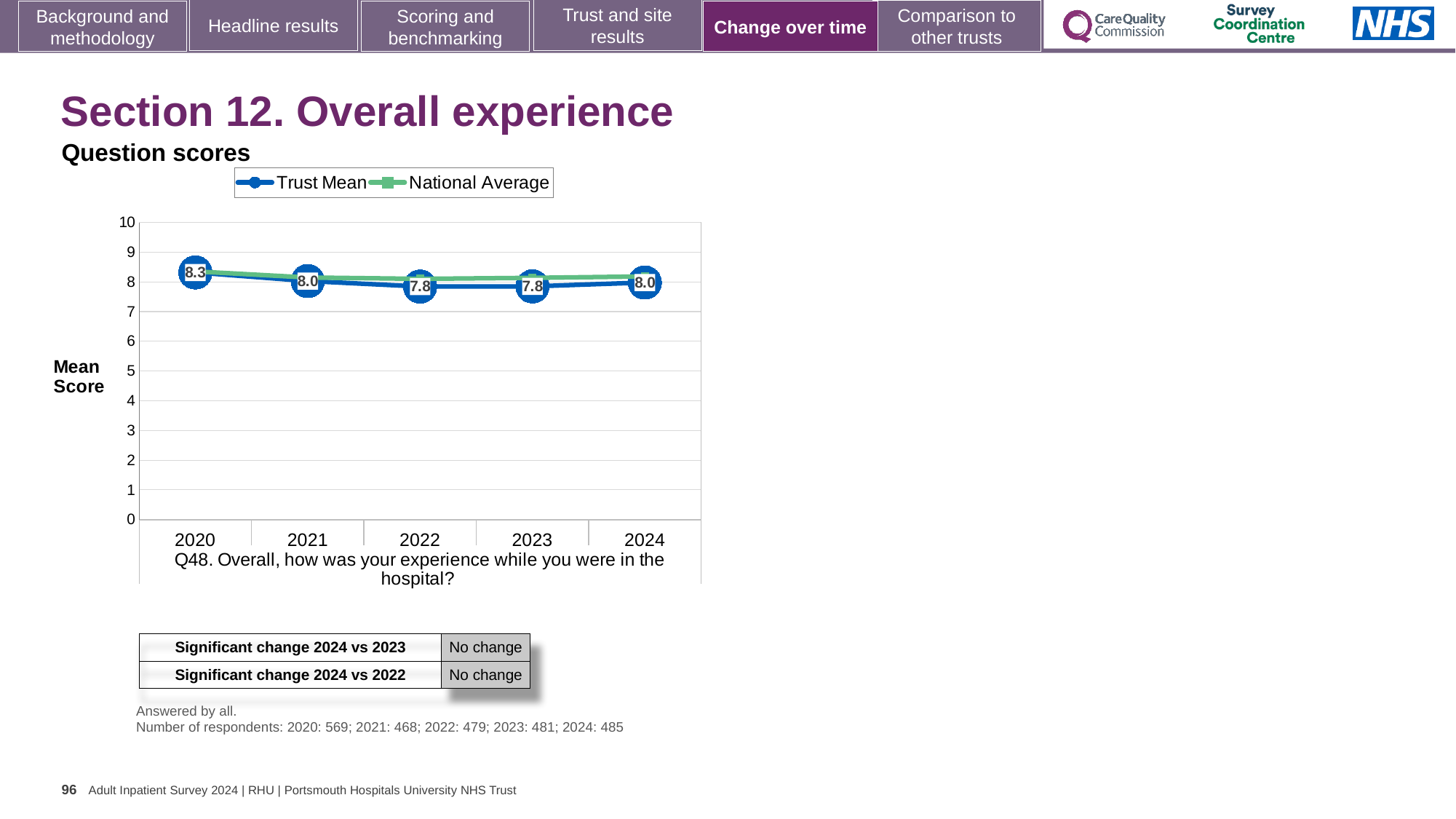
How many series does the legend list? 2 In which year is the Trust Mean score highest? 2020 What is the Trust Mean score for 2020? 8.3 What is the Trust Mean score for 2022? 7.8 What is the difference between the Trust Mean scores for 2020 and 2022? 0.5 Is the National Average value for 2023 greater or less than 7? greater Does the Trust Mean score rise or fall from 2020 to 2022? fall What kind of chart is shown? line chart What is the Trust Mean score for 2024? 8.0 Which year has the larger Trust Mean score, 2021 or 2022? 2021 What is the difference between the Trust Mean scores for 2020 and 2024? 0.3 How many years are plotted on the x axis? 5